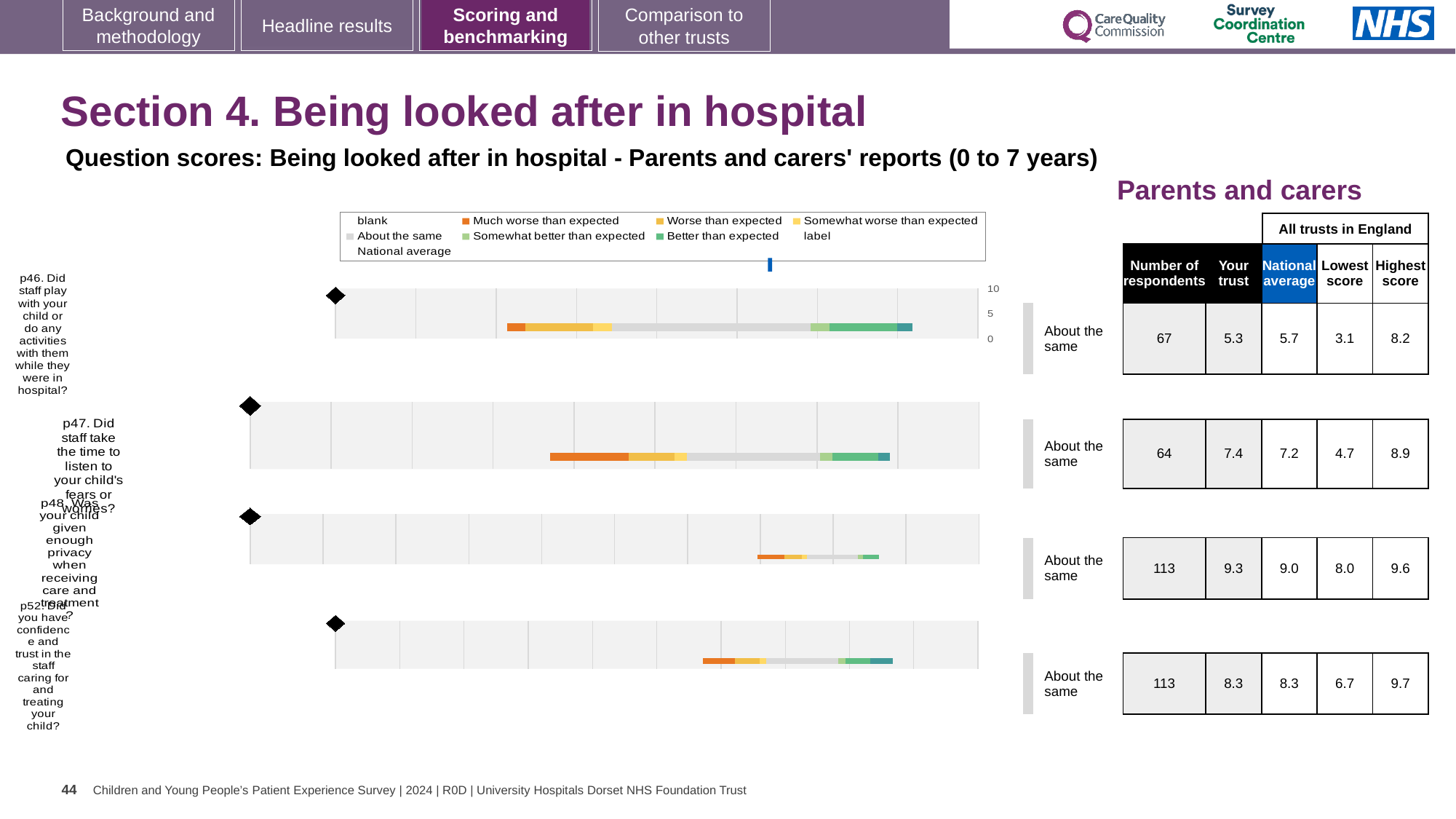
How many respondents answered p48 (Was your child given enough privacy when receiving care and treatment?)? 113 What is the highest score across all trusts in England for p52 (Did you have confidence and trust in the staff caring for and treating your child?)? 9.7 How many questions (categories) are plotted in the chart? 4 What is the benchmark category shown for p52? About the same What kind of chart is used to show the question scores on this slide? bar chart What is the 'Your trust' score for p46 (Did staff play with your child or do any activities with them while they were in hospital?)? 5.3 Which question has the highest 'Your trust' score? p48 What is the lowest score across all trusts in England for p46? 3.1 What is the national average for p47 (Did staff take the time to listen to your child's fears or worries?)? 7.2 Is the 'Your trust' score for p47 higher or lower than the national average for p47? higher What is the difference between the 'Your trust' score and the national average for p46? 0.4 Which question has the lowest 'Your trust' score? p46